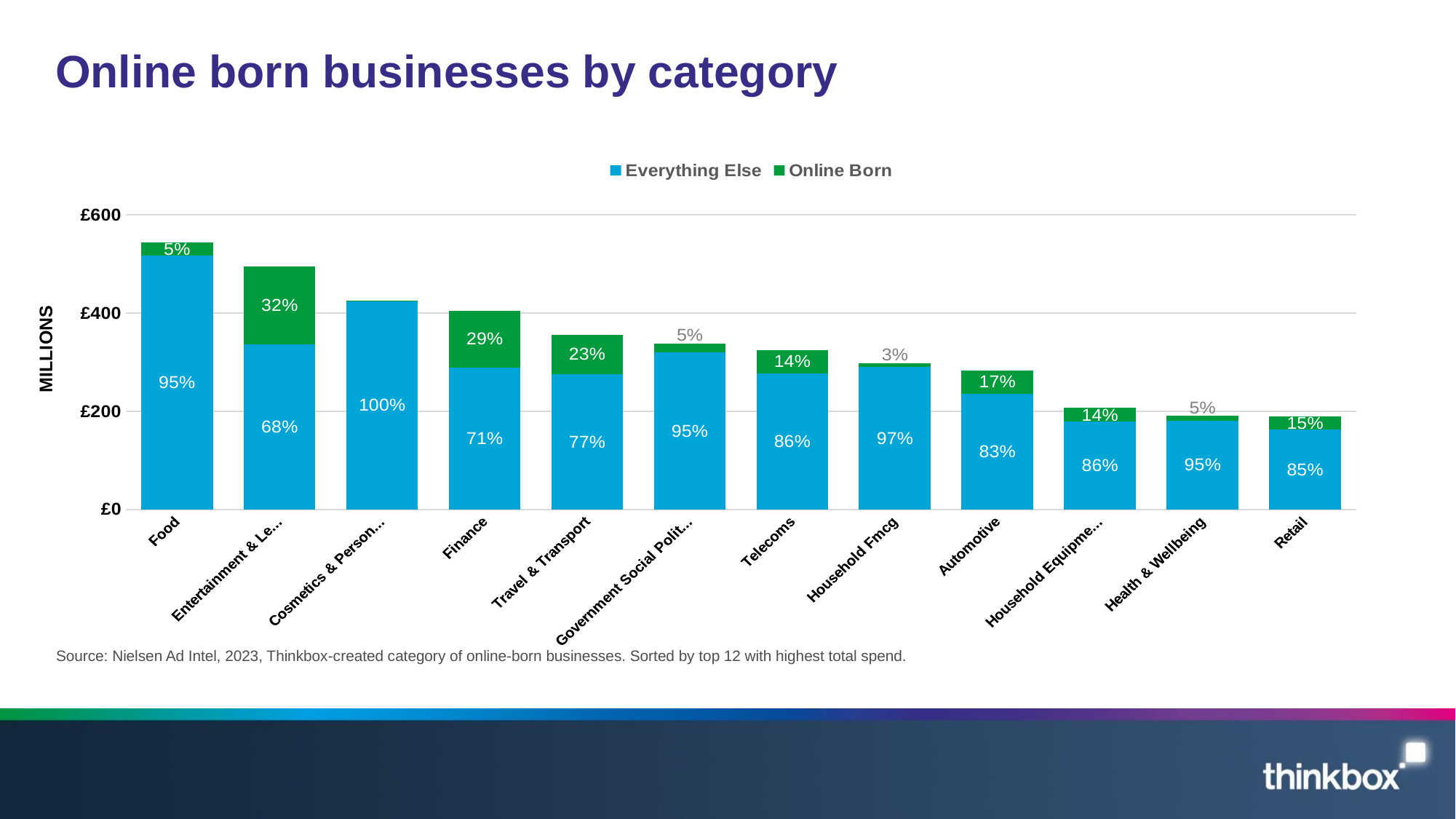
Do the total bar heights generally rise or fall from left to right along the x axis? fall How many series does the legend list? 2 What is the Everything Else percentage for Retail? 85% What is the Online Born percentage for Finance? 29% Is the total bar height for Food greater or less than £400 million? greater Which category has the lowest Online Born percentage label? Household Fmcg What kind of chart is this? Stacked bar chart Which has the larger Online Born percentage, Finance or Travel & Transport? Finance What is the Online Born percentage for Automotive? 17% Is the total bar height for Retail greater or less than £200 million? less How many categories are shown on the x axis? 12 What is the Everything Else percentage for Telecoms? 86%